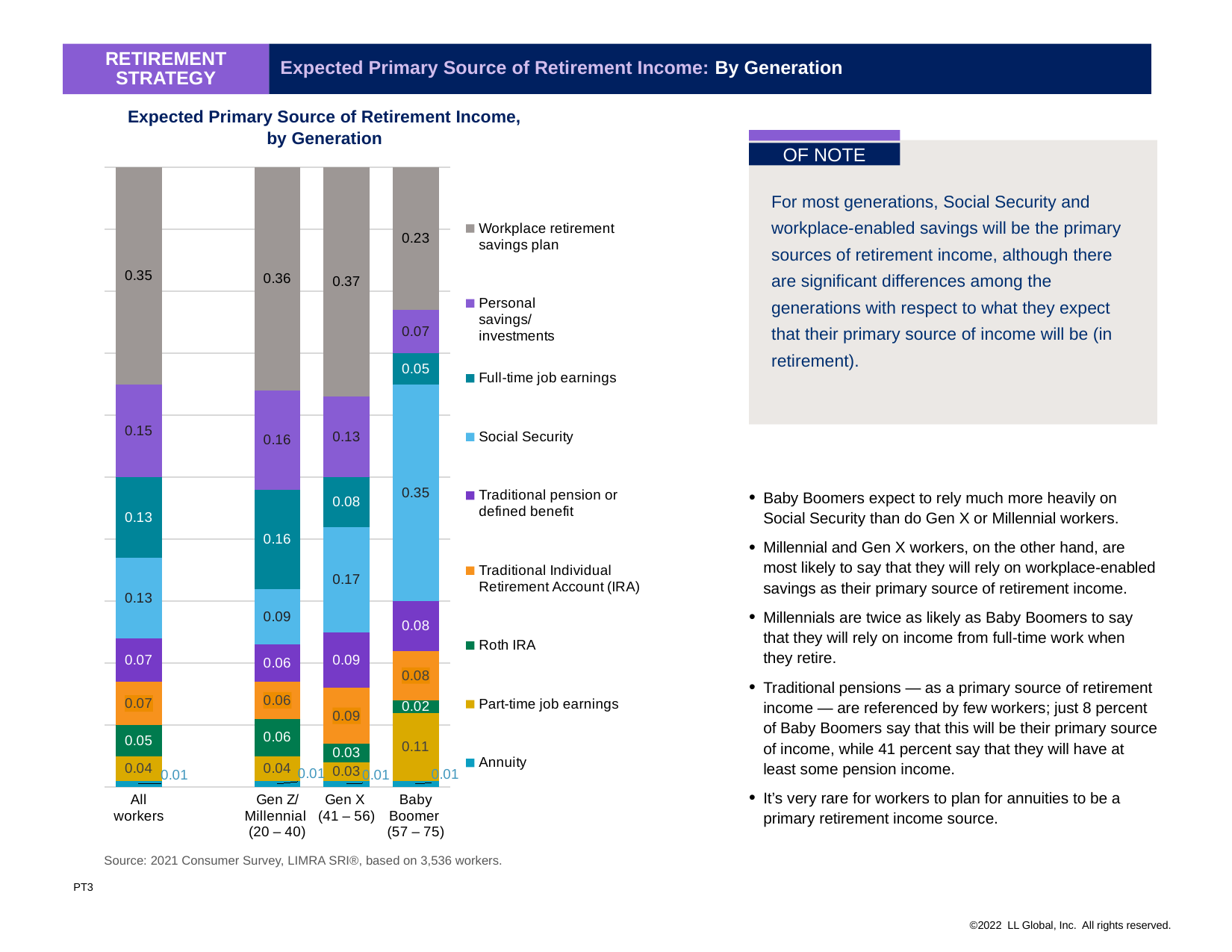
What is the Traditional pension or defined benefit value for Gen X (41 – 56)? 0.09 According to the source note, how many workers was the survey based on? 3,536 workers How many series does the chart's legend list? 9 What kind of chart is shown on the slide? Stacked bar chart Which category has the lowest Workplace retirement savings plan value? Baby Boomer (57 – 75) What is the Social Security value for Baby Boomer (57 – 75)? 0.35 How many generation categories are shown on the x axis of the chart? 4 What is the Part-time job earnings value for Baby Boomer (57 – 75)? 0.11 What is the difference between the Workplace retirement savings plan values for Gen X (41 – 56) and Baby Boomer (57 – 75)? 0.14 Which category has the highest Social Security value? Baby Boomer (57 – 75) What is the Workplace retirement savings plan value for Gen X (41 – 56)? 0.37 Which is larger, the Full-time job earnings value for Gen Z/Millennial (20 – 40) or for Baby Boomer (57 – 75)? Gen Z/Millennial (20 – 40)